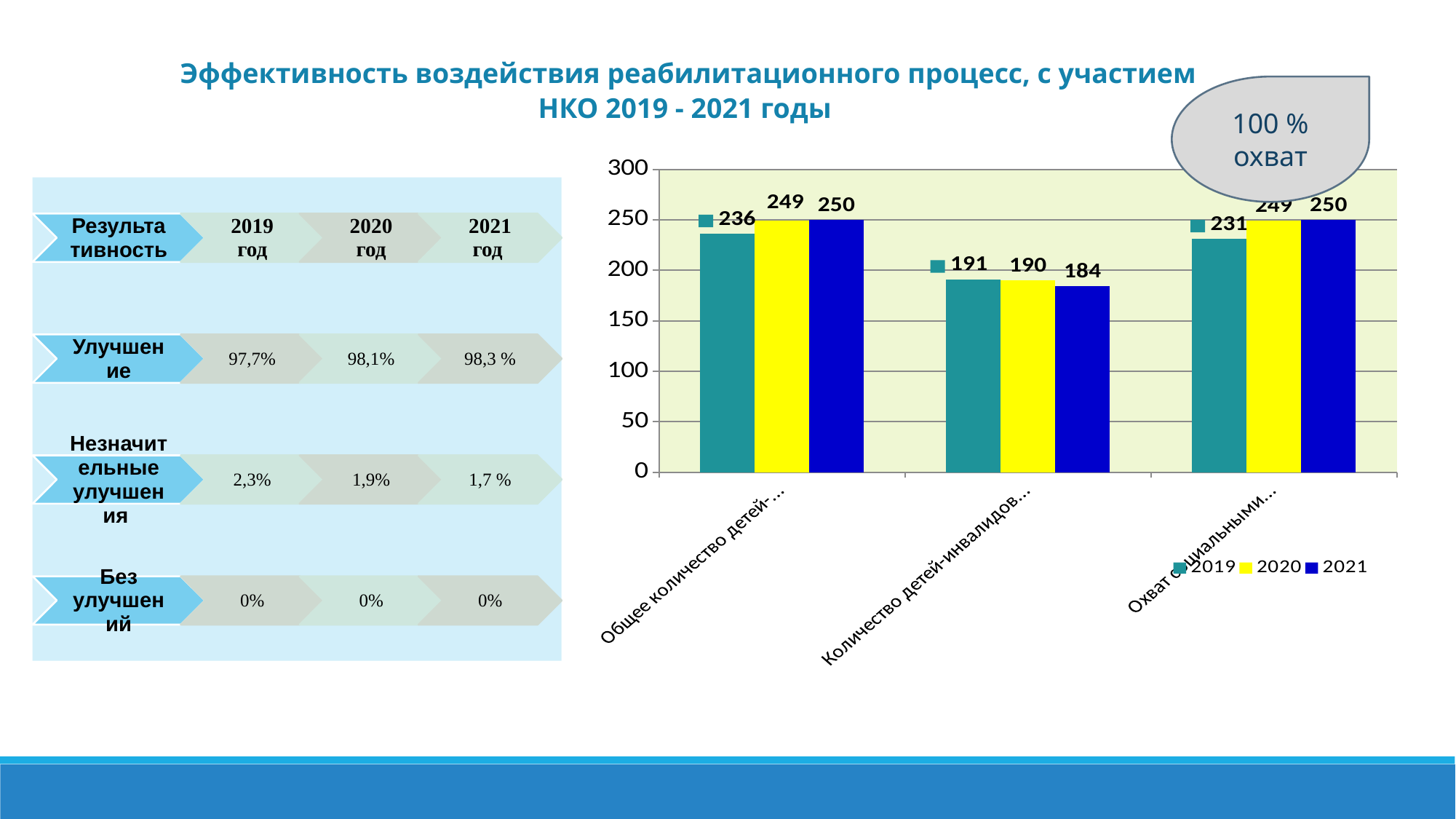
What kind of chart is shown on the slide? bar chart Do the values for the second category (Количество детей-инвалидов...) rise or fall from 2019 to 2021? fall Which year has the lowest value in the second category (Количество детей-инвалидов...)? 2021 What is the difference between the 2021 and 2019 values in the first category (Общее количество детей-...)? 14 How many series does the chart legend list? 3 How many categories are shown on the x axis of the chart? 3 What is the value for 2019 in the first category (Общее количество детей-...)? 236 Which is larger: the 2019 value in the first category or the 2019 value in the third category? the first category (236) What is the value for 2021 in the second category (Количество детей-инвалидов...)? 184 Which colour represents the 2020 series in the chart? yellow What is the value for 2020 in the third category (Охват социальными...)? 249 Which year has the highest value in the third category (Охват социальными...)? 2021